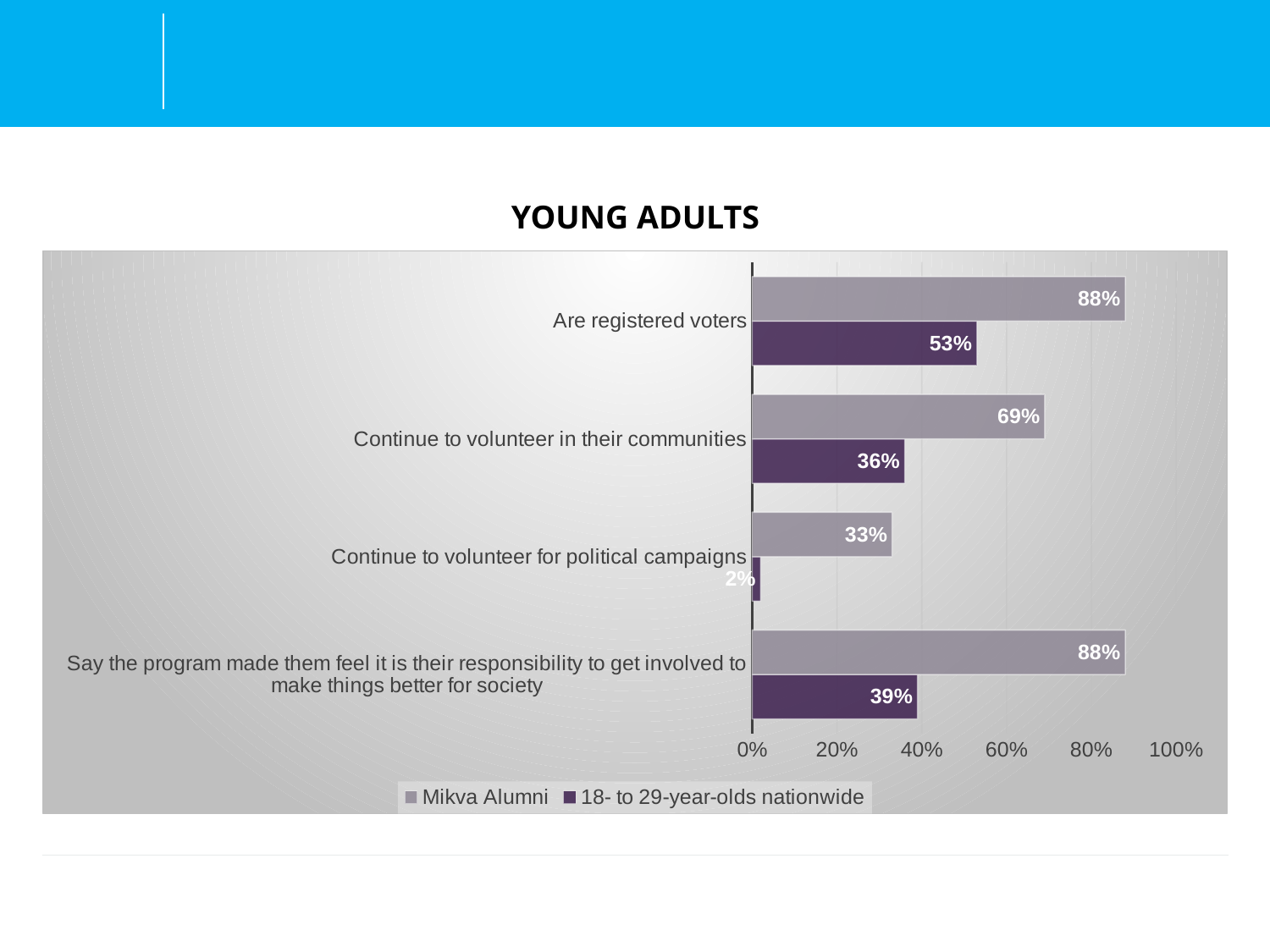
What percentage of 18- to 29-year-olds nationwide continue to volunteer in their communities? 36% How many series does the legend list? 2 What is the difference between Mikva Alumni and 18- to 29-year-olds nationwide for 'Are registered voters'? 35% What is the difference between Mikva Alumni and 18- to 29-year-olds nationwide for 'Continue to volunteer in their communities'? 33% Which category has the lowest value for Mikva Alumni? Continue to volunteer for political campaigns Which category has the highest value for 18- to 29-year-olds nationwide? Are registered voters Which is larger for 'Continue to volunteer for political campaigns': Mikva Alumni or 18- to 29-year-olds nationwide? Mikva Alumni What type of chart is shown on the slide? Bar chart What is the value for 18- to 29-year-olds nationwide who continue to volunteer for political campaigns? 2% How many categories are shown in the chart? 4 What percentage of Mikva Alumni say the program made them feel it is their responsibility to get involved to make things better for society? 88% What percentage of Mikva Alumni are registered voters? 88%